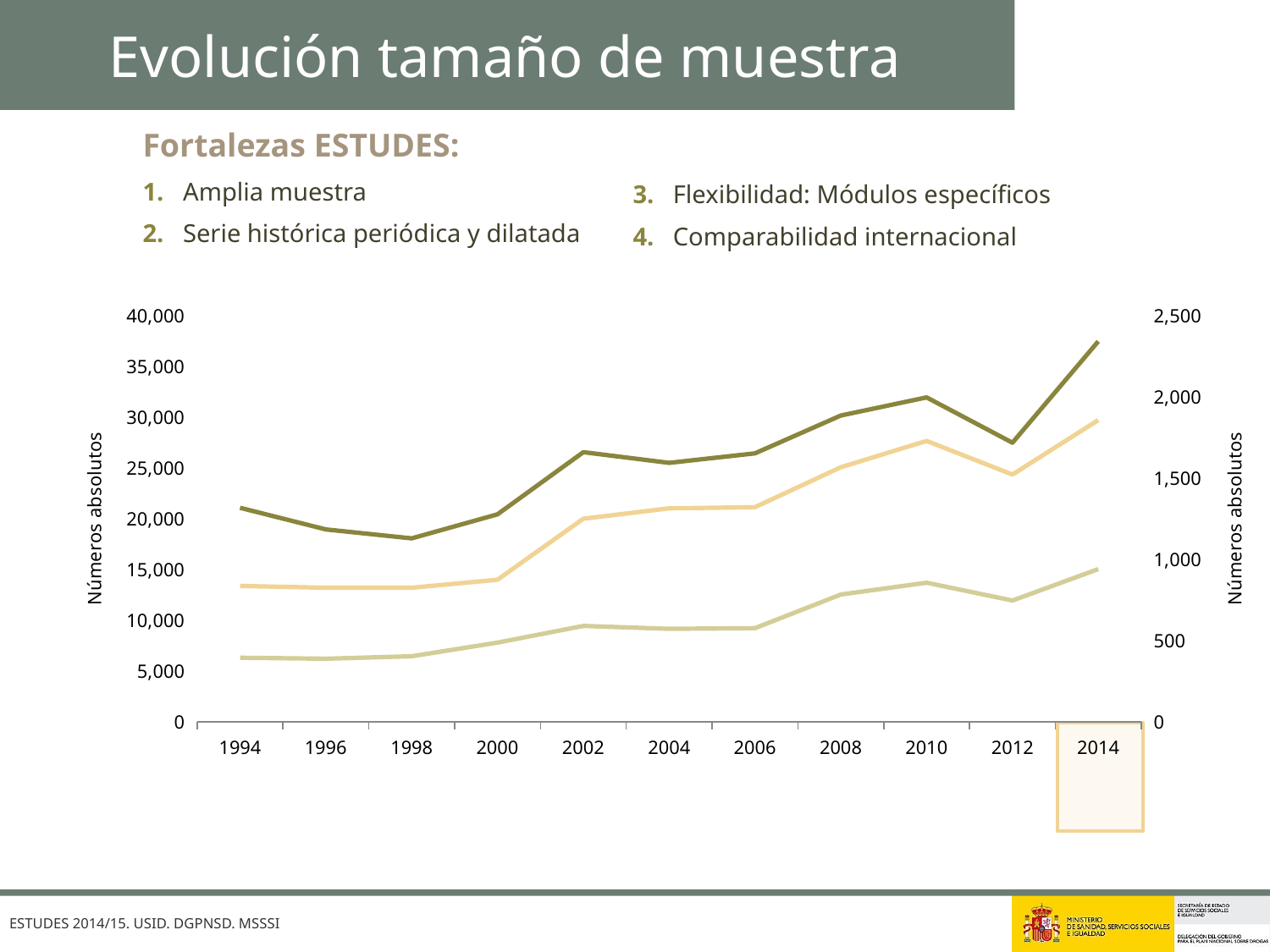
How many lines are plotted on the chart? 3 In which year does the darkest (top) line reach its highest point? 2014 Reading against the left-hand axis, is the value of the darkest (top) line in 2014 greater or less than 35,000? greater Does the middle (light yellow) line rise or fall between 2010 and 2012? fall What is the label of the left-hand vertical axis of the chart? Números absolutos In which year does the darkest (top) line reach its lowest point? 1998 In 2010, which line is higher on the chart: the darkest line or the pale green line? the darkest line How many years are labelled along the x axis of the chart? 11 Does the darkest (top) line rise or fall between 2012 and 2014? rise What is the first year shown on the x axis of the chart? 1994 Reading against the left-hand axis, is the value of the lowest (pale green) line in 1994 greater or less than 10,000? less What kind of chart is shown on the slide? line chart